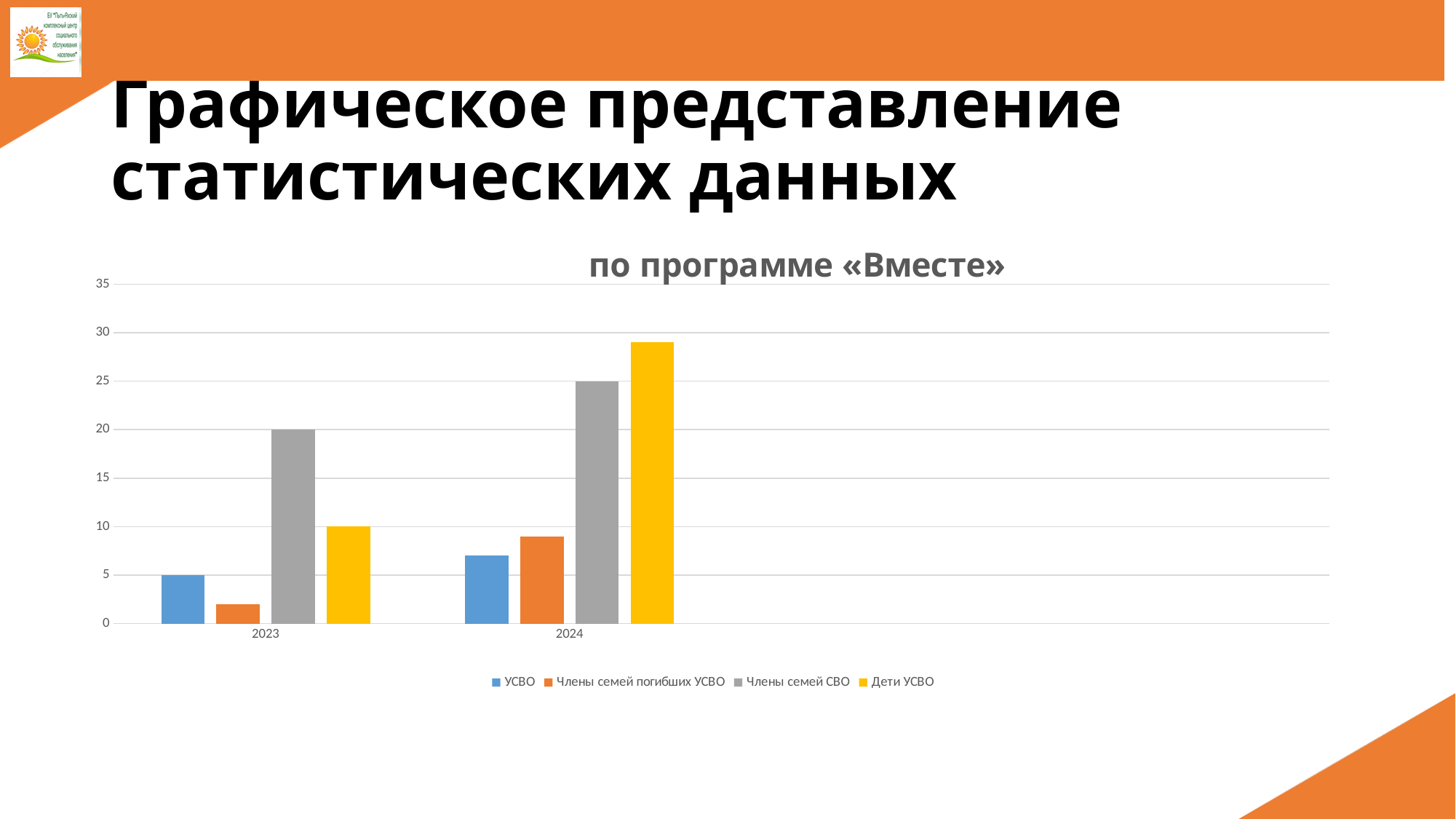
How many series does the legend list? 4 What is the value for Члены семей СВО in 2023? 20 What is the value for УСВО in 2023? 5 What is the value for Члены семей СВО in 2024? 25 What kind of chart is shown on the slide? bar chart Is the value for Дети УСВО in 2024 greater or less than 25? greater Is the value for Члены семей погибших УСВО in 2023 greater or less than 5? less What is the value for Дети УСВО in 2023? 10 Does the value for Члены семей СВО rise or fall from 2023 to 2024? rise How many categories are shown on the x axis? 2 What is the title of the chart? по программе «Вместе» Which series has the highest value in 2024? Дети УСВО